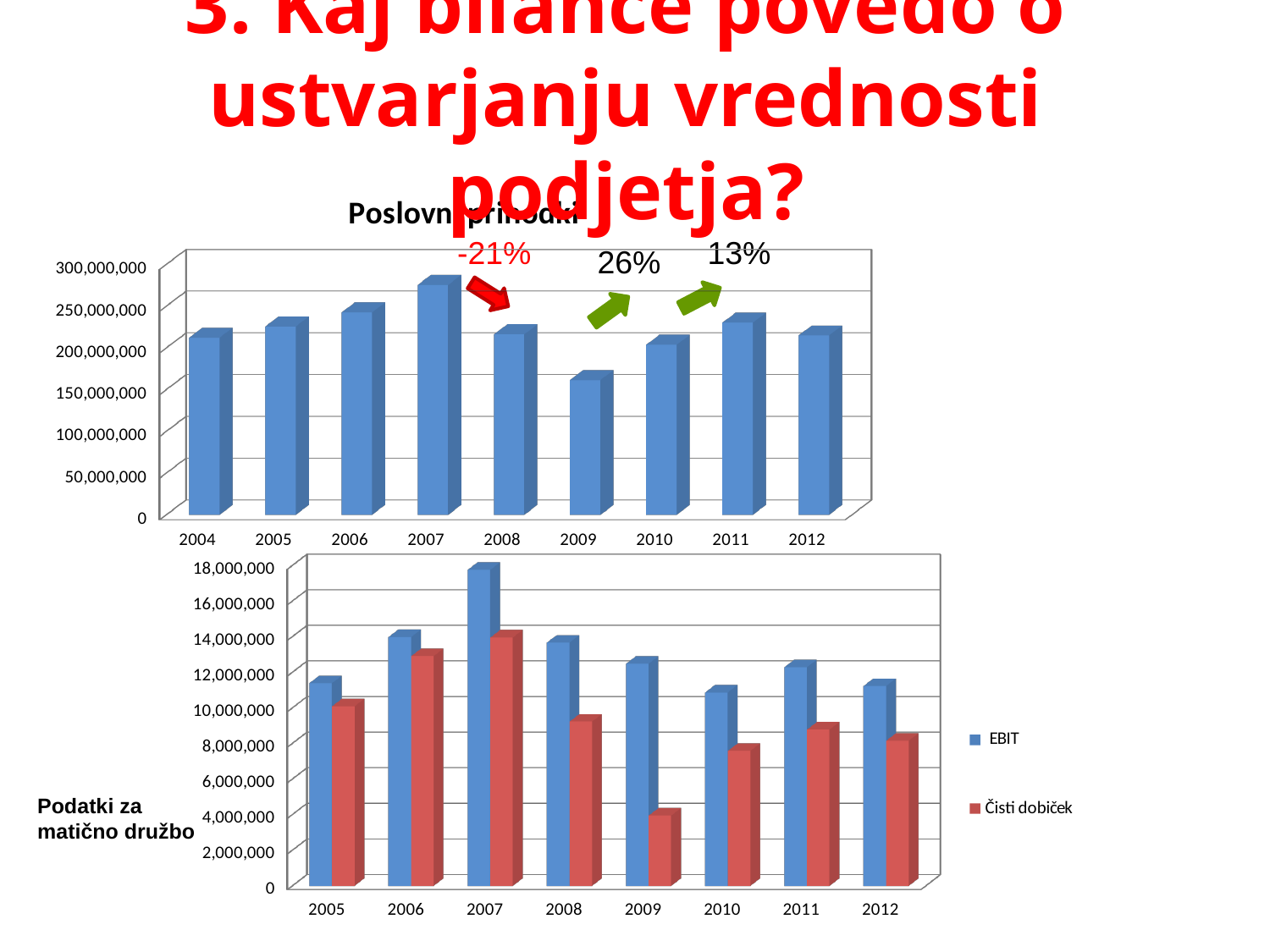
In the top chart, which is larger, the value for 2011 or the value for 2009? 2011 How many years are shown on the x axis of the top chart? 9 How many series does the legend of the bottom chart list? 2 In the top chart, is the value for 2009 greater or less than 200,000,000? less In the bottom chart, is the Čisti dobiček value for 2009 greater or less than 6,000,000? less In the top chart, which year has the lowest bar? 2009 In the bottom chart, which year has the lowest Čisti dobiček bar? 2009 In the top chart, which year has the highest bar? 2007 In the bottom chart, which year has the highest EBIT bar? 2007 In the top chart, is the value for 2007 greater or less than 250,000,000? greater In the top chart, do the values rise or fall from 2004 to 2007? rise What kind of chart is the top chart on the slide? bar chart